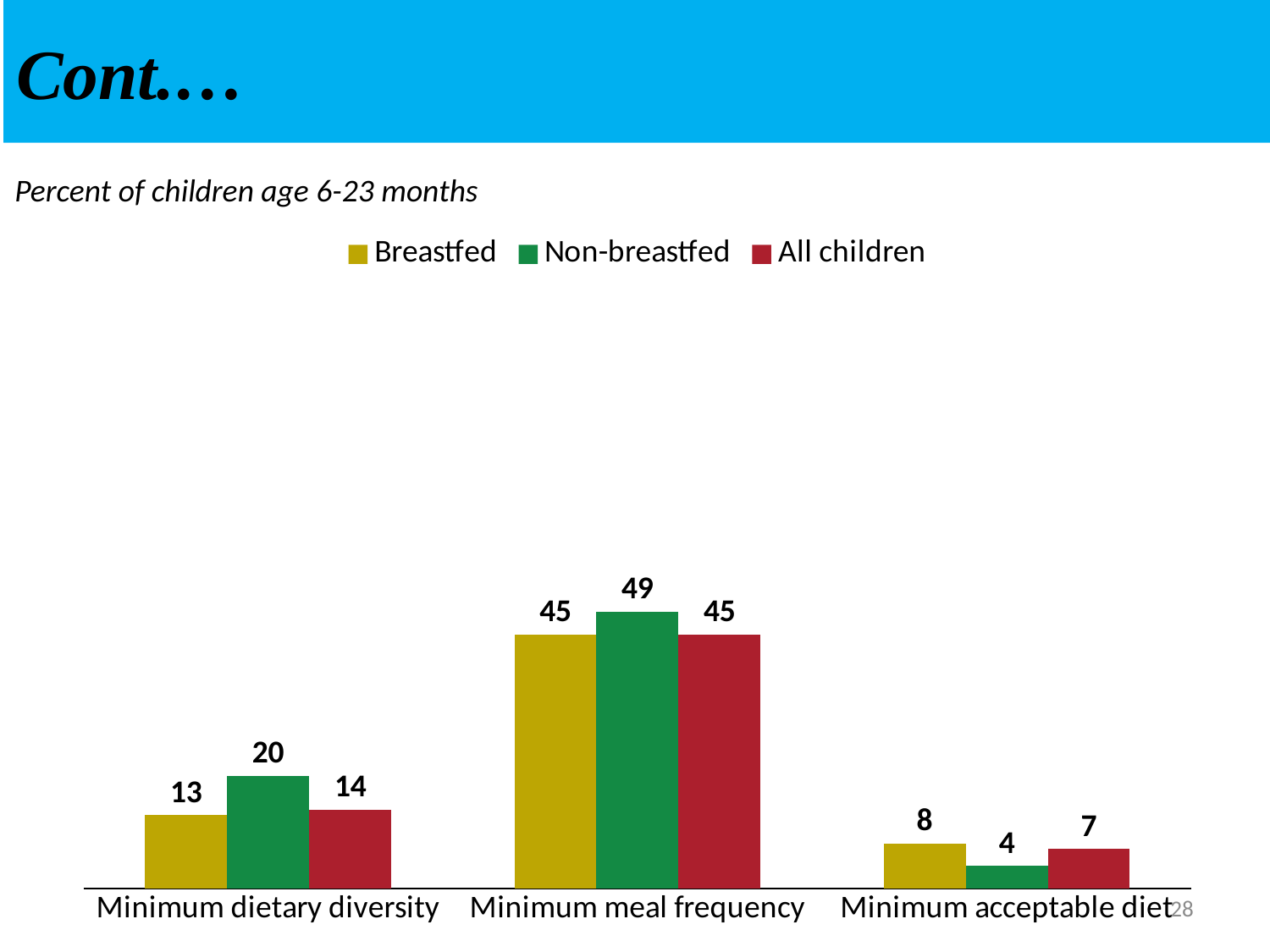
Which category has the lowest value for Breastfed children? Minimum acceptable diet How many series does the legend list? 3 What is the difference between the Non-breastfed and Breastfed values for Minimum dietary diversity? 7 What is the value for Non-breastfed children for Minimum acceptable diet? 4 Which series is shown in green in the legend? Non-breastfed Which is larger for Minimum acceptable diet: the Breastfed value or the Non-breastfed value? Breastfed How many categories are shown on the x axis? 3 Which category has the highest value for Non-breastfed children? Minimum meal frequency What is the value for Breastfed children for Minimum meal frequency? 45 What is the value for All children for Minimum acceptable diet? 7 What kind of chart is shown on the slide? Bar chart What is the value for Non-breastfed children for Minimum dietary diversity? 20